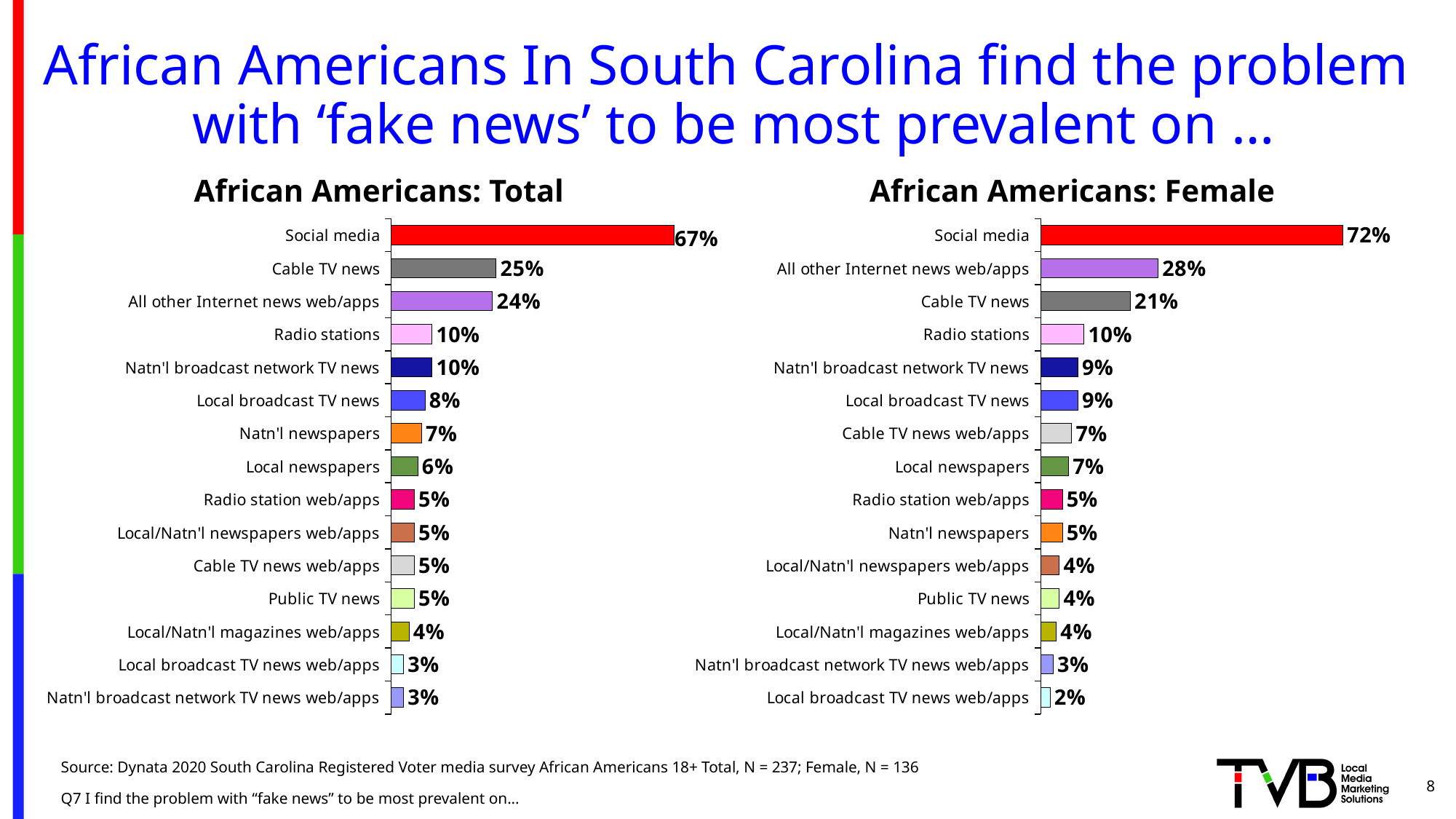
How many categories are shown in the 'African Americans: Female' chart? 15 In the 'African Americans: Female' chart, what is the value for All other Internet news web/apps? 28% In the 'African Americans: Total' chart, what is the difference between Social media and Cable TV news? 42% In the 'African Americans: Total' chart, which category has the highest value? Social media In the 'African Americans: Female' chart, what is the difference between Social media and All other Internet news web/apps? 44% In the 'African Americans: Female' chart, which category has the lowest value? Local broadcast TV news web/apps Which is larger in the 'African Americans: Total' chart: Cable TV news or All other Internet news web/apps? Cable TV news What type of chart is the 'African Americans: Female' chart? Bar chart In the 'African Americans: Total' chart, what is the value for Social media? 67% How many categories are shown in the 'African Americans: Total' chart? 15 In the 'African Americans: Female' chart, what is the value for Cable TV news? 21% What is the title of the chart on the left side of the slide? African Americans: Total